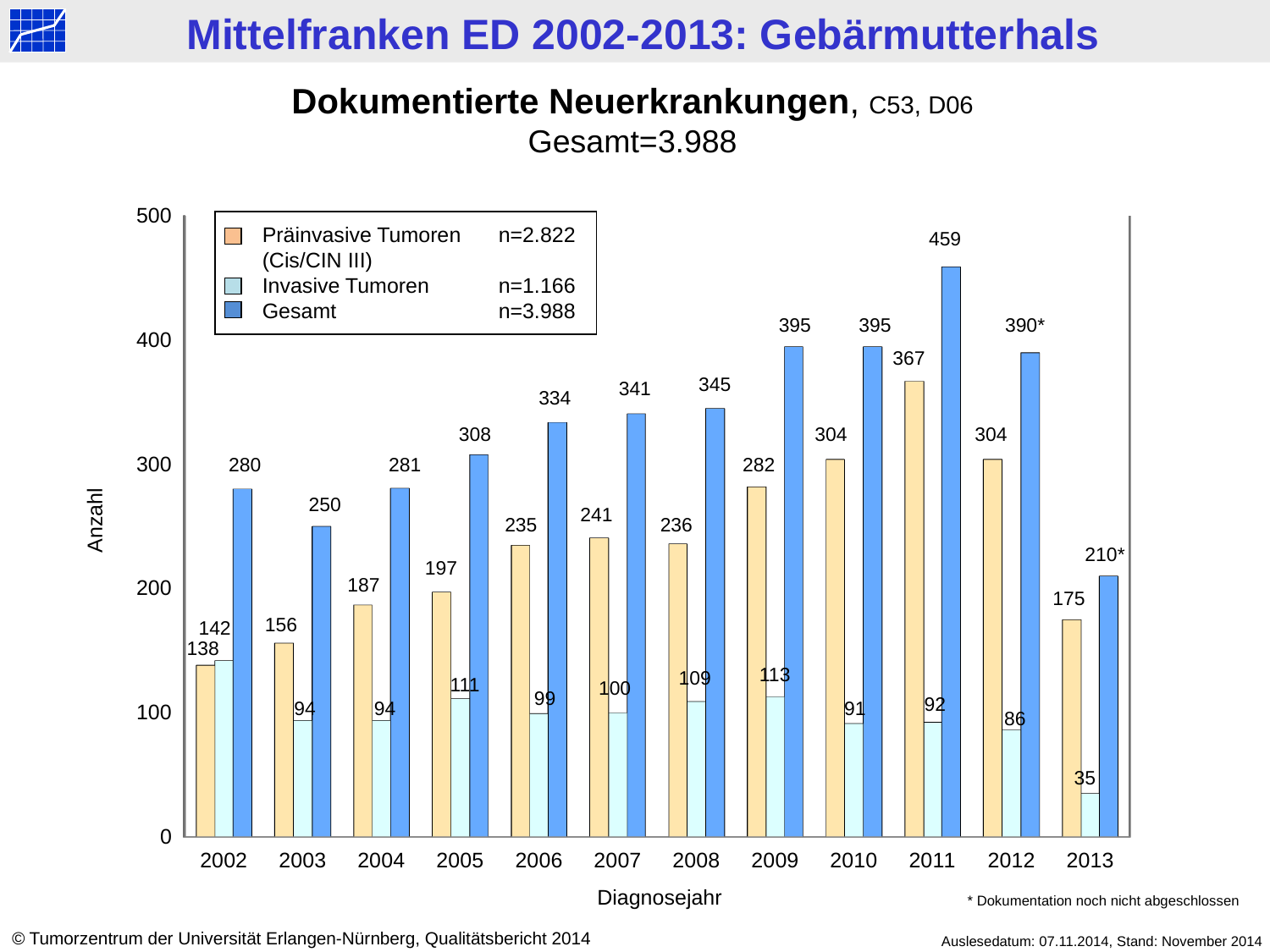
Which year has the lowest value for Invasive Tumoren? 2013 What is the value for Invasive Tumoren in 2005? 111 What is the difference between the Gesamt values for 2011 and 2010? 64 How many diagnosis years are shown on the x axis? 12 Which year has the highest Gesamt value? 2011 What kind of chart is shown on the slide? Bar chart What is the Gesamt value for 2011? 459 Which is larger in 2002: Präinvasive Tumoren or Invasive Tumoren? Invasive Tumoren What is the value for Präinvasive Tumoren (Cis/CIN III) in 2009? 282 Is the Gesamt value for 2006 greater or less than 300? greater What is the n value given in the legend for Präinvasive Tumoren (Cis/CIN III)? n=2.822 How many series does the legend list? 3